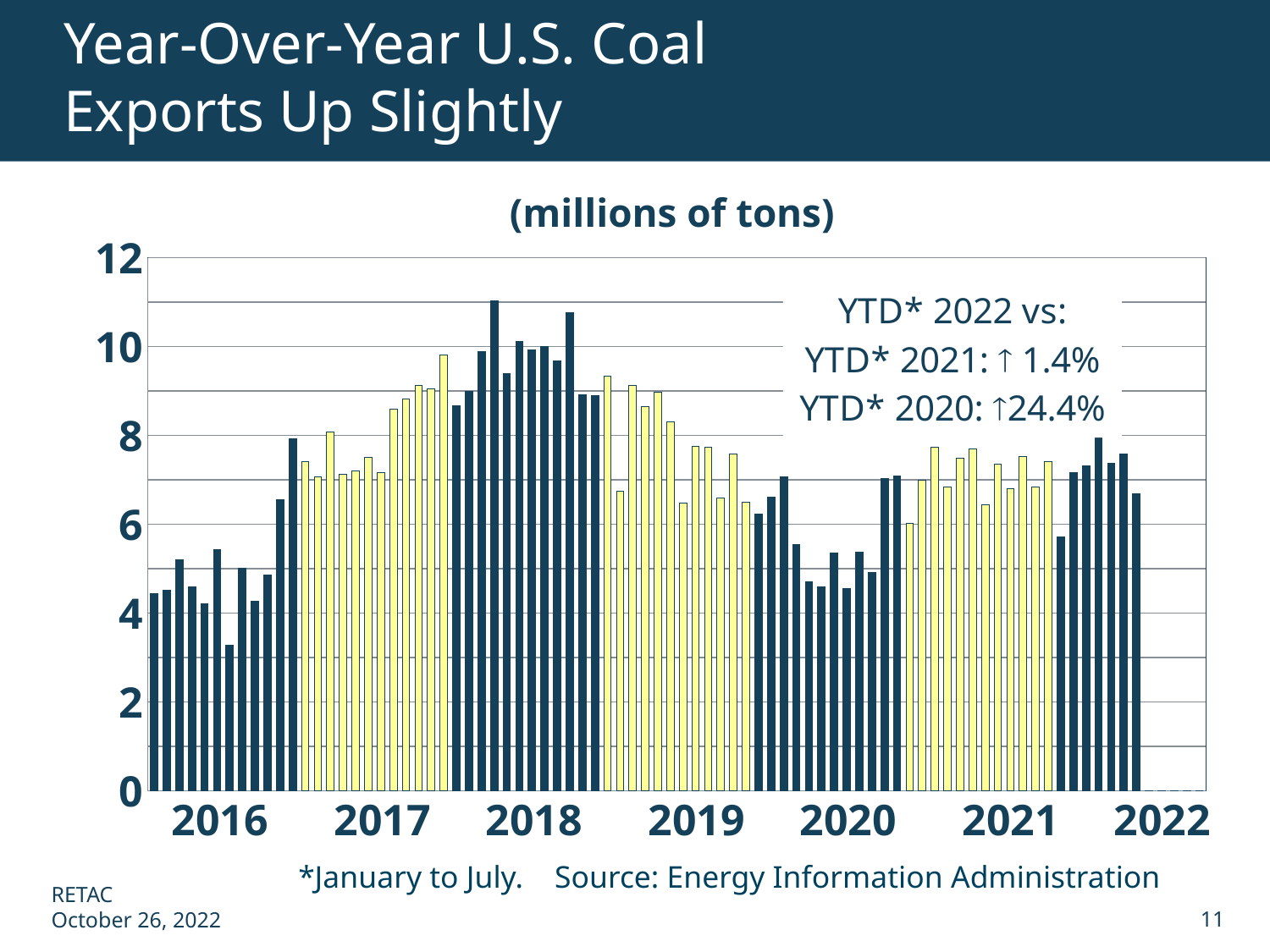
According to the annotation on the chart, by what percentage are YTD 2022 coal exports up versus YTD 2021? 1.4% In which year does the shortest bar on the chart occur? 2016 What kind of chart is shown on the slide? bar chart What unit is given in the chart's title? millions of tons Do the monthly values generally rise or fall from 2016 to 2018? rise Is the value of the lowest bar in 2020 greater or less than 6? less Do the monthly values generally rise or fall from 2018 to 2020? fall In which year does the tallest bar on the chart occur? 2018 Is the value of the shortest bar in 2016 greater or less than 4? less Which year has the higher peak monthly value, 2018 or 2020? 2018 How many years are labeled along the x axis of the chart? 7 Is the value of the tallest bar in 2018 greater or less than 10? greater